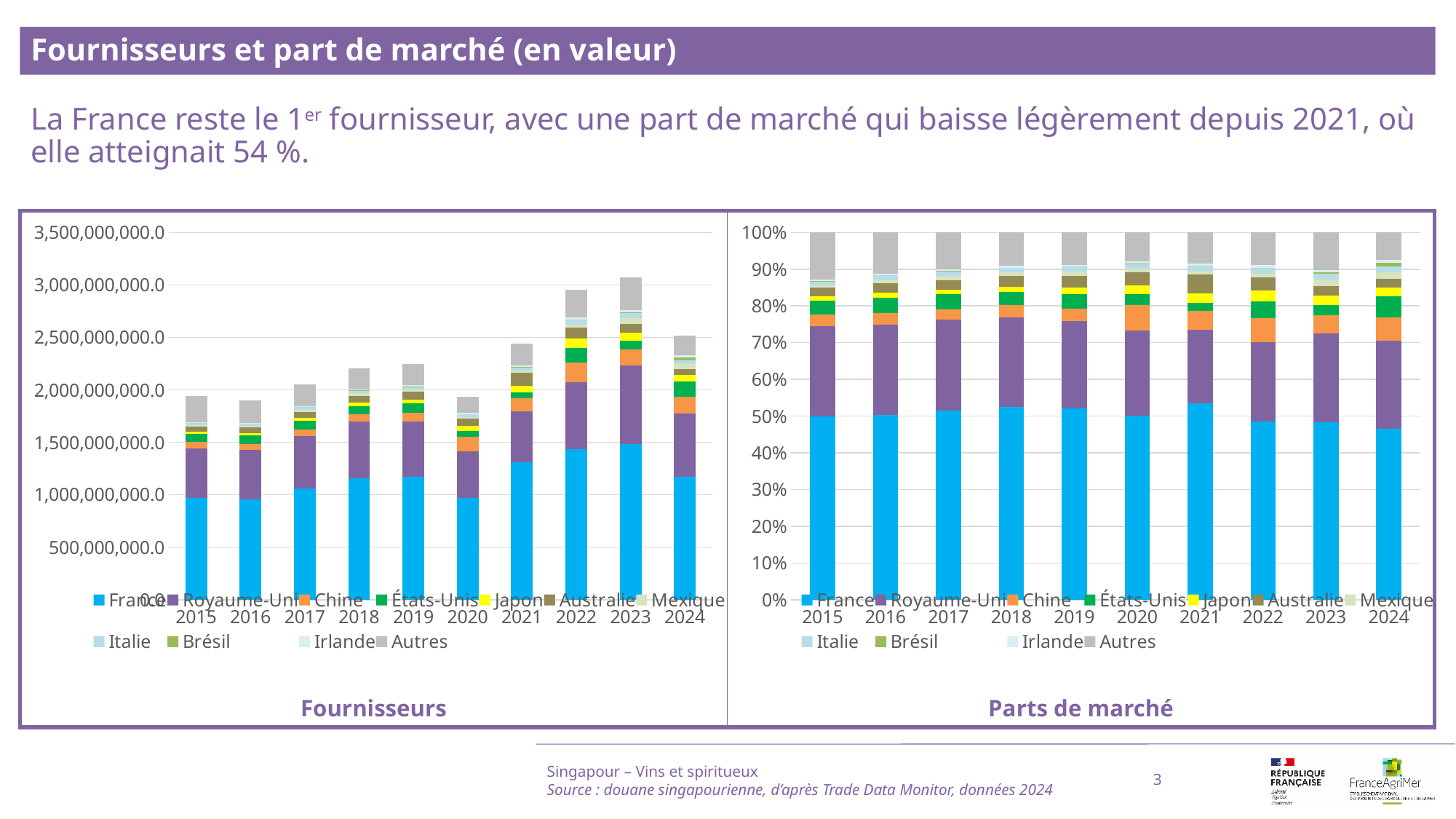
In the 'Fournisseurs' chart, which year has the tallest total bar? 2023 In the 'Fournisseurs' chart, is the total bar for 2023 taller than the total bar for 2024? yes How many years are shown on the x axis of the 'Parts de marché' chart? 10 How many series does the legend of the 'Fournisseurs' chart list? 11 In the 'Fournisseurs' chart, is the total value for 2022 greater or less than 2,500,000,000.0? greater What is the title shown under the right-hand chart? Parts de marché In the 'Fournisseurs' chart, do the total bars generally rise or fall from 2015 to 2023? rise Which series is shown in blue at the bottom of each bar in both charts? France In the 'Parts de marché' chart, is the share for France in 2021 greater or less than 50%? greater What kind of chart is the 'Fournisseurs' chart on the left? stacked bar chart In the 'Parts de marché' chart, is the share for France in 2024 greater or less than 50%? less